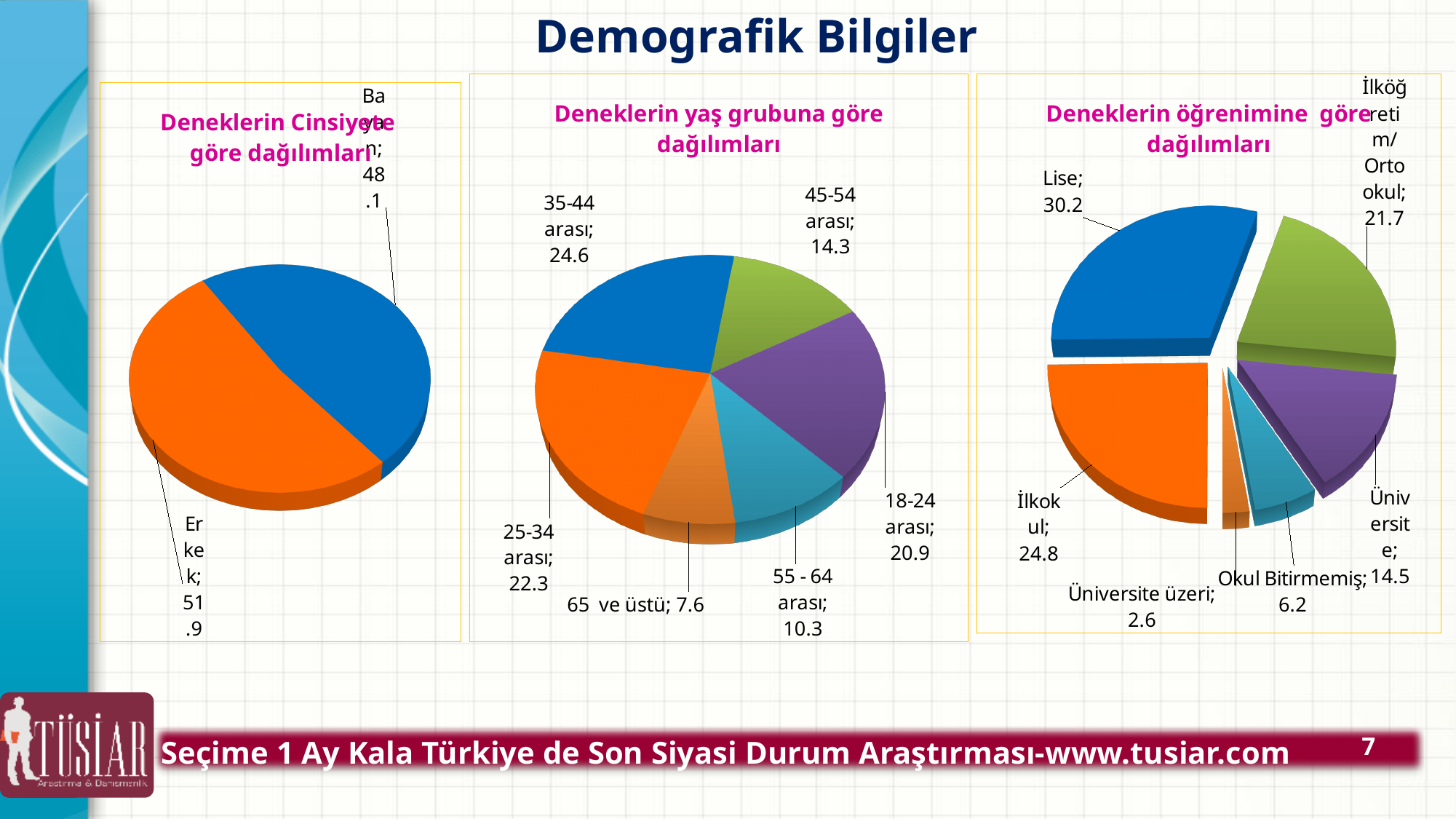
In the right chart (Deneklerin öğrenimine göre dağılımları), what is the difference between the İlkokul and Üniversite values? 10.3 In the middle chart (Deneklerin yaş grubuna göre dağılımları), what is the value for 35-44 arası? 24.6 In the middle chart (Deneklerin yaş grubuna göre dağılımları), which age group has the smallest share? 65 ve üstü In the left chart (Deneklerin Cinsiyete göre dağılımları), what is the value for Erkek? 51.9 In the middle chart (Deneklerin yaş grubuna göre dağılımları), how many age groups are shown? 6 In the left chart (Deneklerin Cinsiyete göre dağılımları), what is the difference between the Erkek and Bayan values? 3.8 What kind of chart is used for the three charts on this slide? Pie chart In the middle chart (Deneklerin yaş grubuna göre dağılımları), which is larger: 18-24 arası or 25-34 arası? 25-34 arası In the middle chart (Deneklerin yaş grubuna göre dağılımları), which age group has the largest share? 35-44 arası In the left chart (Deneklerin Cinsiyete göre dağılımları), what is the value for Bayan? 48.1 In the right chart (Deneklerin öğrenimine göre dağılımları), what is the value for Üniversite üzeri? 2.6 In the right chart (Deneklerin öğrenimine göre dağılımları), what is the value for Lise? 30.2